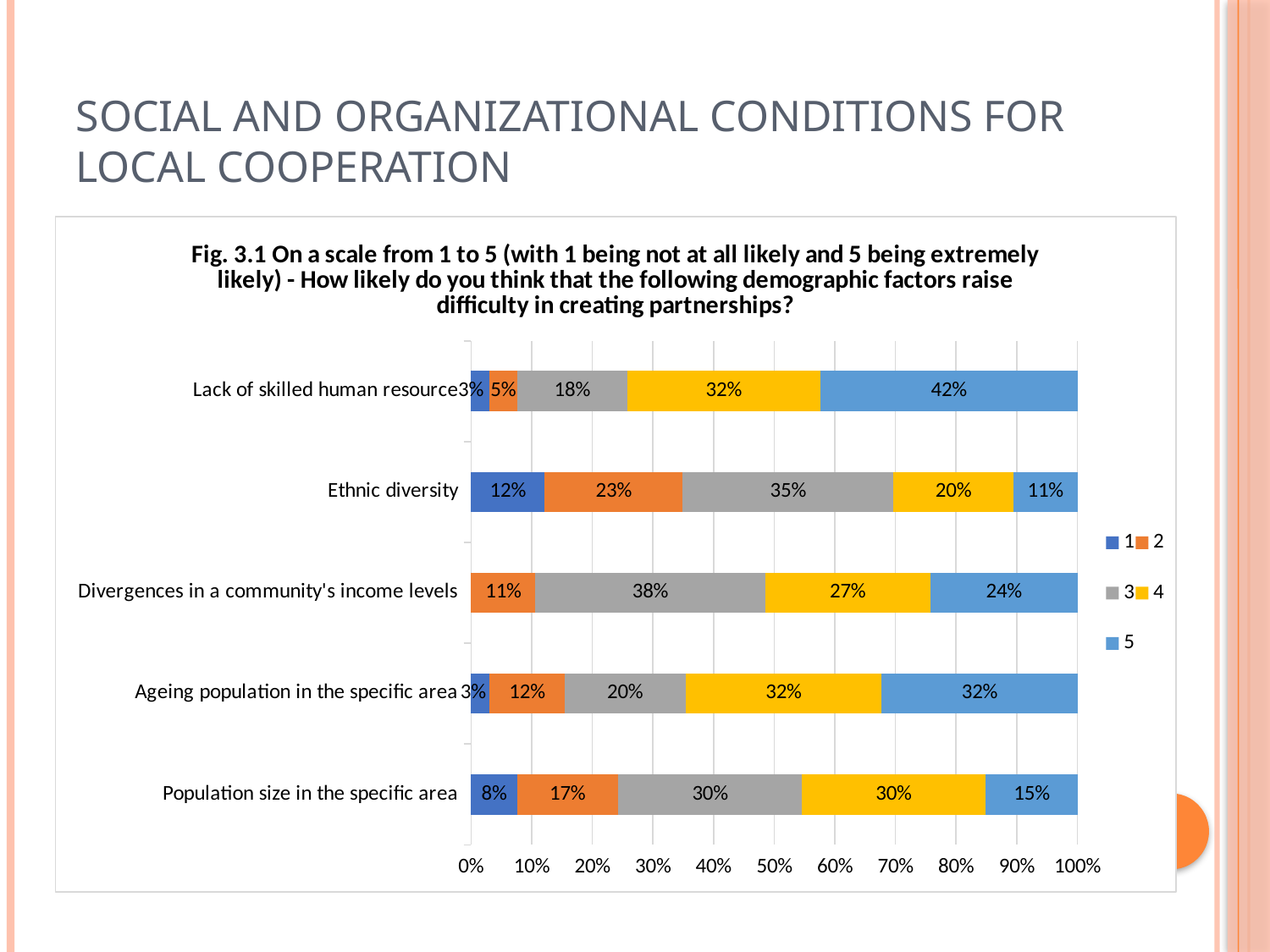
Which colour represents the rating 3 in the chart? Grey How many series does the legend list? 5 What percentage of respondents rated 'Divergences in a community's income levels' as 4? 27% What percentage of respondents rated 'Lack of skilled human resource' as 5? 42% What percentage of respondents rated 'Ethnic diversity' as 3? 35% Which is larger: the share rating 'Ageing population in the specific area' as 5 or the share rating 'Population size in the specific area' as 5? Ageing population in the specific area What is the difference between the share rating 'Ethnic diversity' as 2 and the share rating 'Ageing population in the specific area' as 2? 11% What kind of chart is shown on the slide? Stacked bar chart How many demographic factors (categories) are plotted in the chart? 5 What percentage of respondents rated 'Population size in the specific area' as 1? 8% Which demographic factor has the highest share of respondents rating it 5? Lack of skilled human resource Which demographic factor has the lowest share of respondents rating it 5? Ethnic diversity